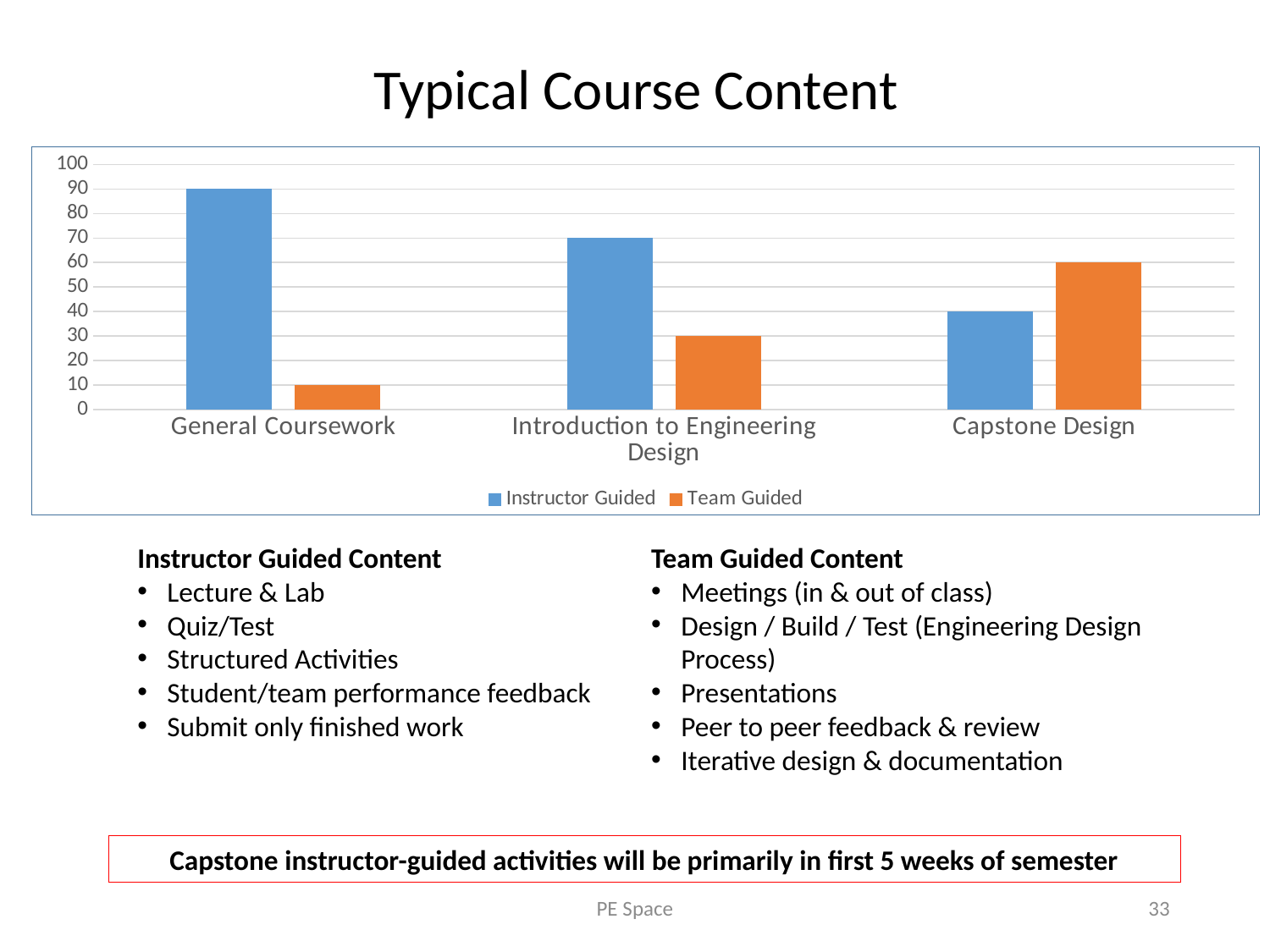
What is the Instructor Guided value for Introduction to Engineering Design? 70 What is the Team Guided value for Capstone Design? 60 What is the difference between the Instructor Guided and Team Guided values for General Coursework? 80 Do the Instructor Guided values rise or fall from left to right across the categories? fall Which colour represents the Team Guided series in the legend? orange For Capstone Design, which is larger: Instructor Guided or Team Guided? Team Guided Which category has the highest Instructor Guided value? General Coursework How many categories are shown on the x axis? 3 How many series does the legend list? 2 What kind of chart is shown on the slide? bar chart Which category has the lowest Team Guided value? General Coursework What is the Instructor Guided value for General Coursework? 90